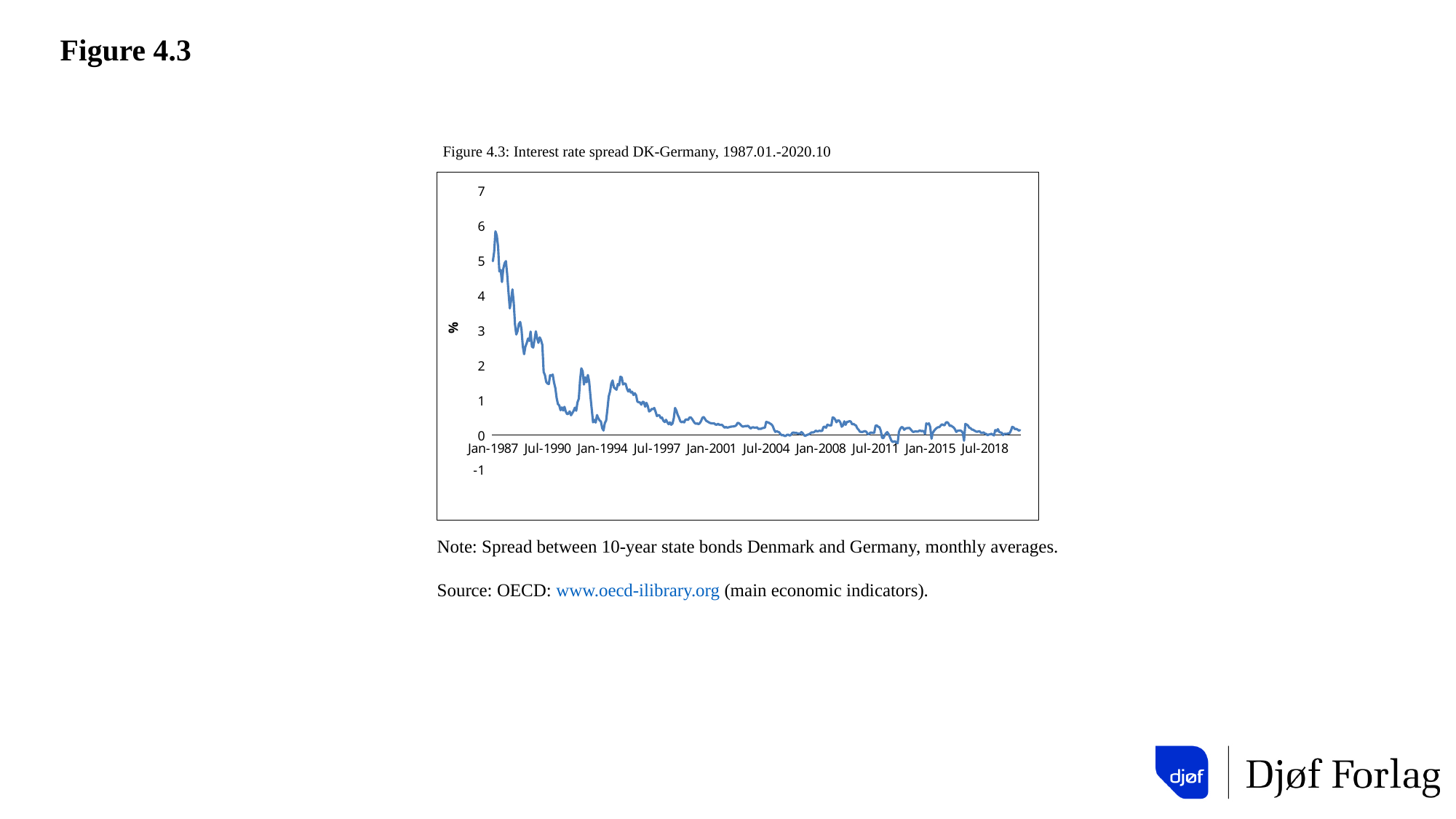
How many tick labels are shown on the horizontal axis? 10 Is the highest value reached by the line greater or less than 5? greater Is the value around Jul-2018 greater or less than 1? less What is the label on the vertical axis of the chart? % Which is larger, the value at Jan-1987 or the value at Jul-2018? Jan-1987 Overall, do the values rise or fall from Jan-1987 to Jul-2018? fall Is the value at the start of the series (Jan-1987) greater or less than 4? greater In which year does the line reach its highest value? 1987 What is the title of the chart? Figure 4.3: Interest rate spread DK-Germany, 1987.01.-2020.10 What kind of chart is shown on the slide? line chart